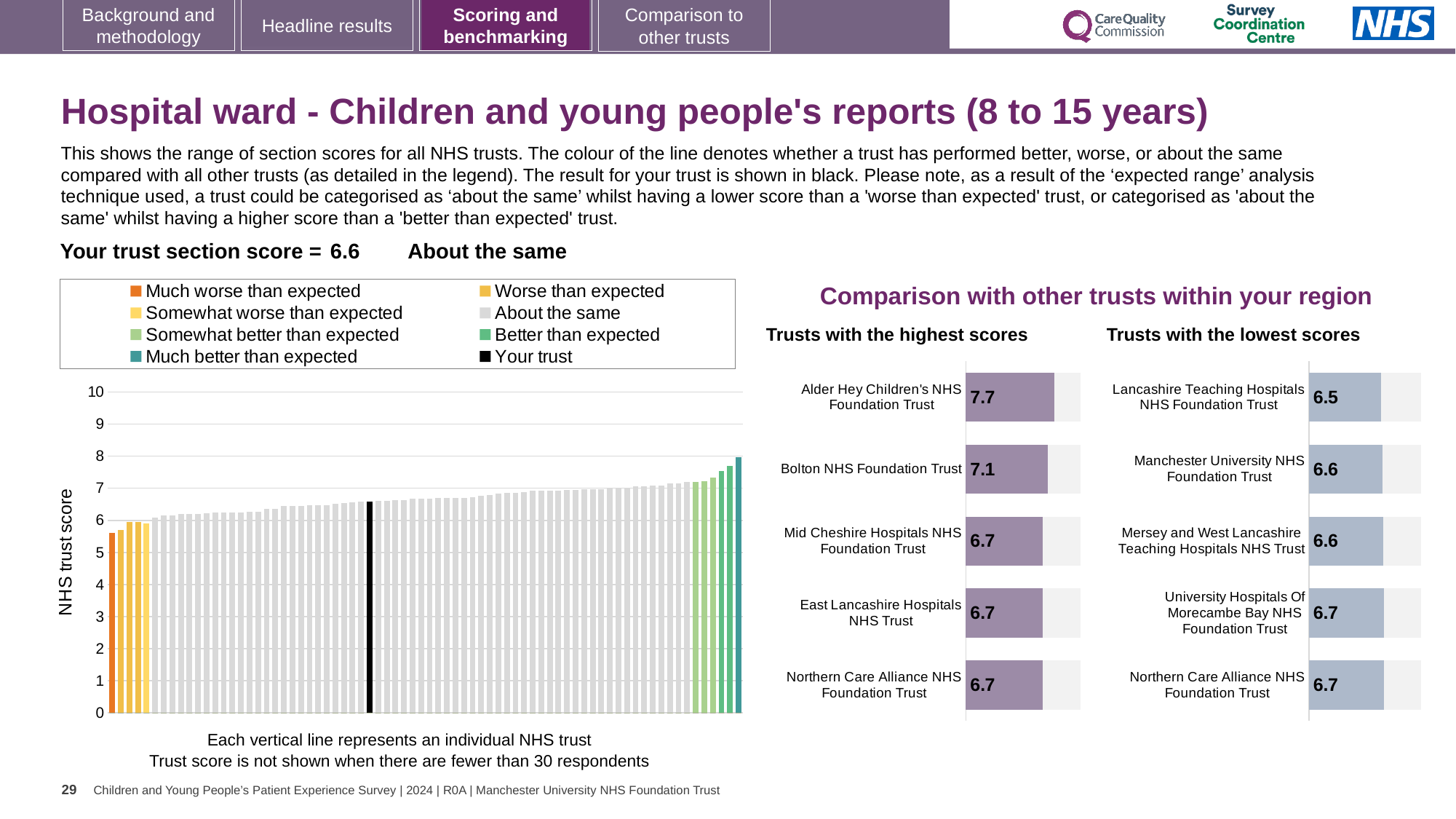
In the 'Trusts with the lowest scores' chart, what is the score for Lancashire Teaching Hospitals NHS Foundation Trust? 6.5 In the 'Trusts with the lowest scores' chart, which trust has the lowest score? Lancashire Teaching Hospitals NHS Foundation Trust In the large chart on the left showing all NHS trusts, is the value of the leftmost (orange) bar greater or less than 6? less How many entries does the legend of the large chart on the left list? 8 In the 'Trusts with the highest scores' chart, what is the difference between the scores of Alder Hey Children's NHS Foundation Trust and Bolton NHS Foundation Trust? 0.6 How many trusts are listed in the 'Trusts with the highest scores' chart? 5 In the 'Trusts with the highest scores' chart, what is the score for Bolton NHS Foundation Trust? 7.1 Which is larger: the score for Alder Hey Children's NHS Foundation Trust in the highest scores chart, or the score for Lancashire Teaching Hospitals NHS Foundation Trust in the lowest scores chart? Alder Hey Children's NHS Foundation Trust In the 'Trusts with the highest scores' chart, which trust has the highest score? Alder Hey Children's NHS Foundation Trust In the large chart on the left showing all NHS trusts, do the bar values rise or fall from left to right? rise In the 'Trusts with the highest scores' chart, what is the score for Alder Hey Children's NHS Foundation Trust? 7.7 In the 'Trusts with the lowest scores' chart, what is the score for Manchester University NHS Foundation Trust? 6.6